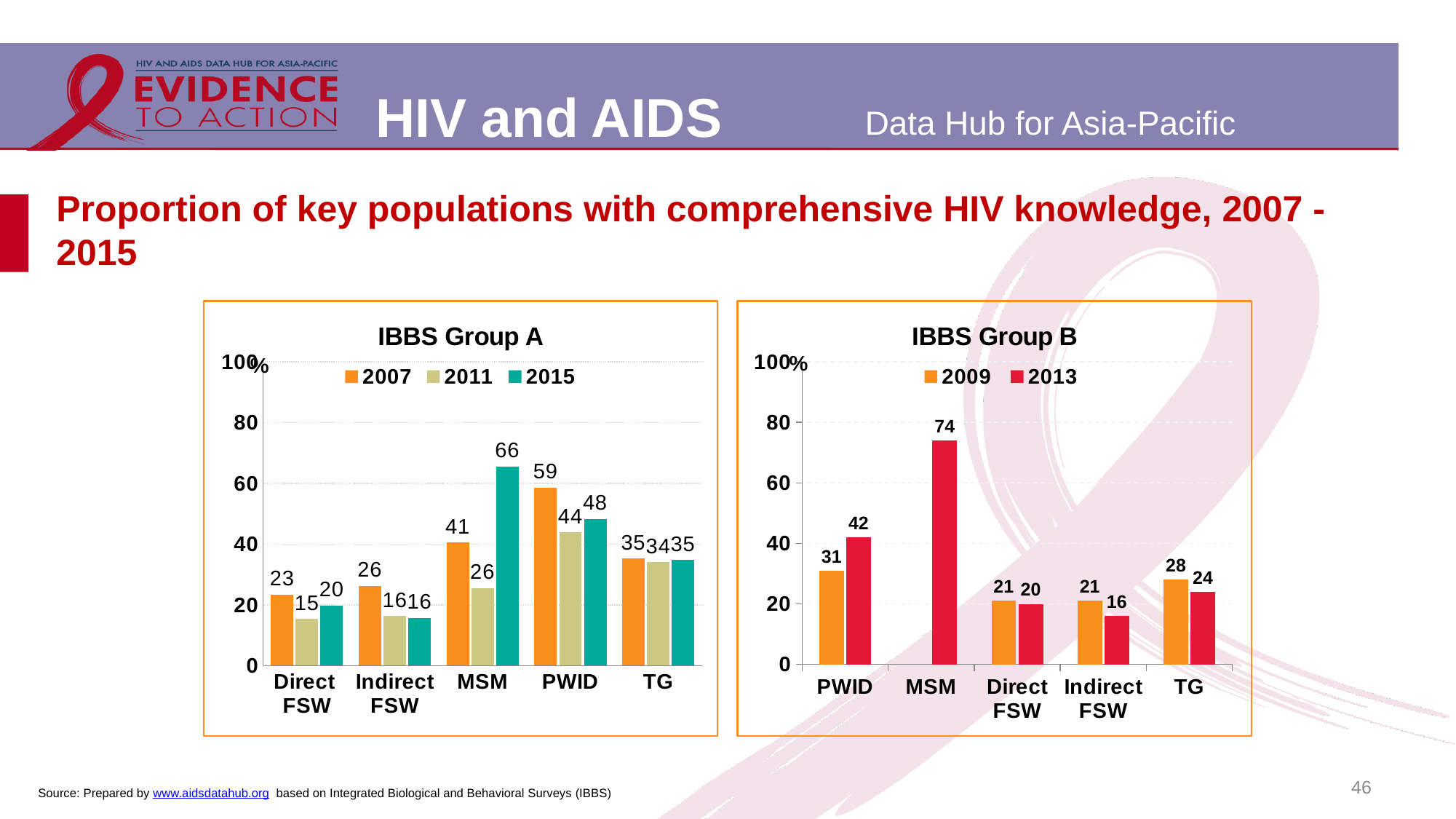
In the IBBS Group A chart, which category has the highest value in 2015? MSM In the IBBS Group A chart, what is the difference between the 2015 and 2007 values for MSM? 25 In the IBBS Group A chart, what is the value for PWID in 2007? 59 In the IBBS Group A chart, what is the value for MSM in 2015? 66 In the IBBS Group B chart, what is the value for MSM in 2013? 74 In the IBBS Group B chart, which is larger for Indirect FSW: the 2009 value or the 2013 value? 2009 In the IBBS Group A chart, which category has the lowest value in 2011? Direct FSW In the IBBS Group B chart, what is the value for PWID in 2009? 31 What kind of chart is the IBBS Group B chart? Bar chart In the IBBS Group B chart, what is the difference between the 2013 and 2009 values for PWID? 11 In the IBBS Group B chart, how many categories are shown on the x axis? 5 In the IBBS Group A chart, how many series does the legend list? 3